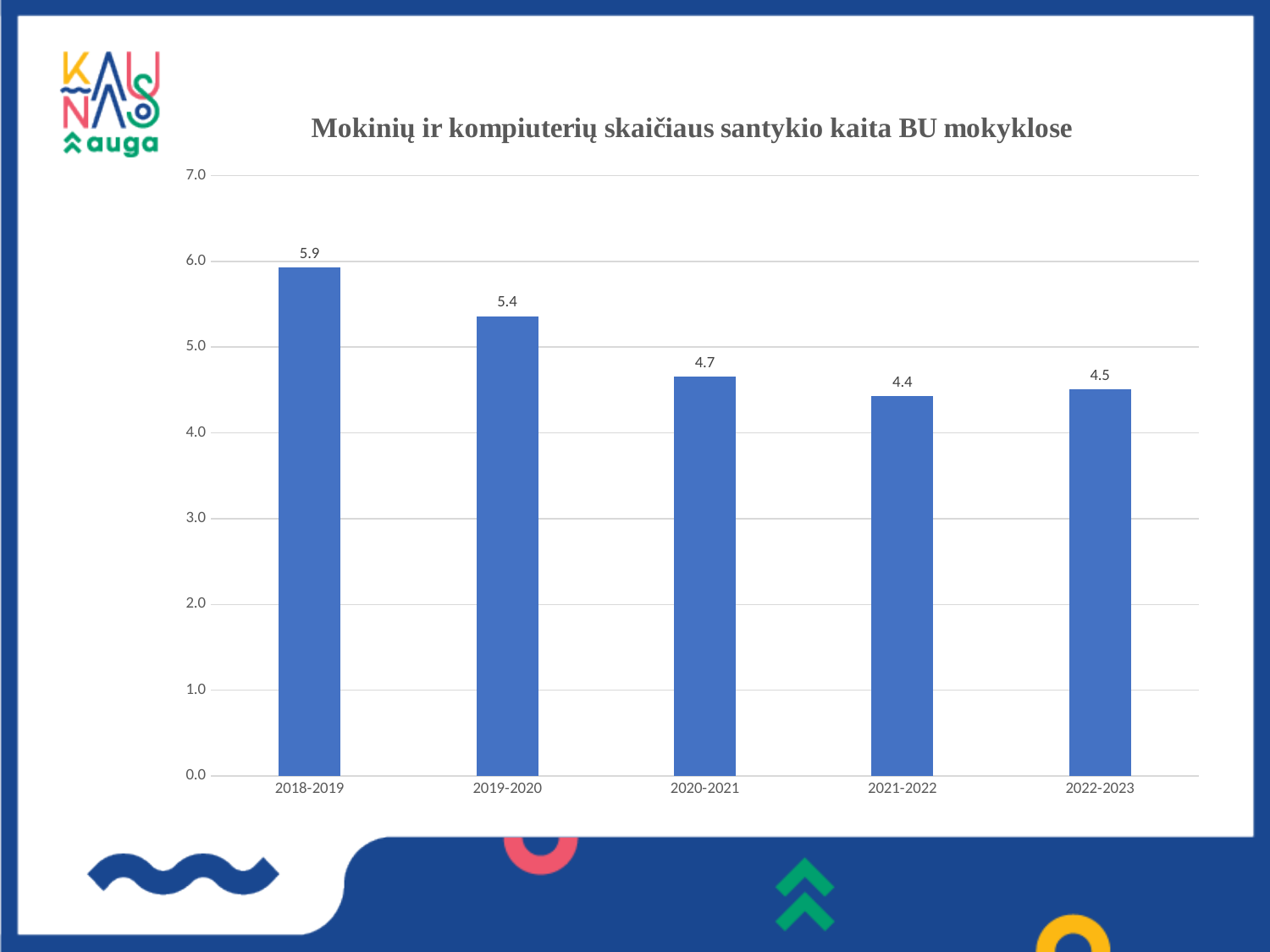
What is the difference between the values for 2018-2019 and 2019-2020? 0.5 What is the value for 2020-2021? 4.7 What kind of chart is shown on the slide? bar chart How many school years are shown on the x axis? 5 Which is larger, the value for 2019-2020 or the value for 2020-2021? 2019-2020 What is the difference between the values for 2019-2020 and 2021-2022? 1.0 What is the value for 2022-2023? 4.5 What is the title of the chart? Mokinių ir kompiuterių skaičiaus santykio kaita BU mokyklose What is the value for 2018-2019? 5.9 Which school year has the lowest value? 2021-2022 Is the value for 2020-2021 greater or less than 5.0? less Which school year has the highest value? 2018-2019